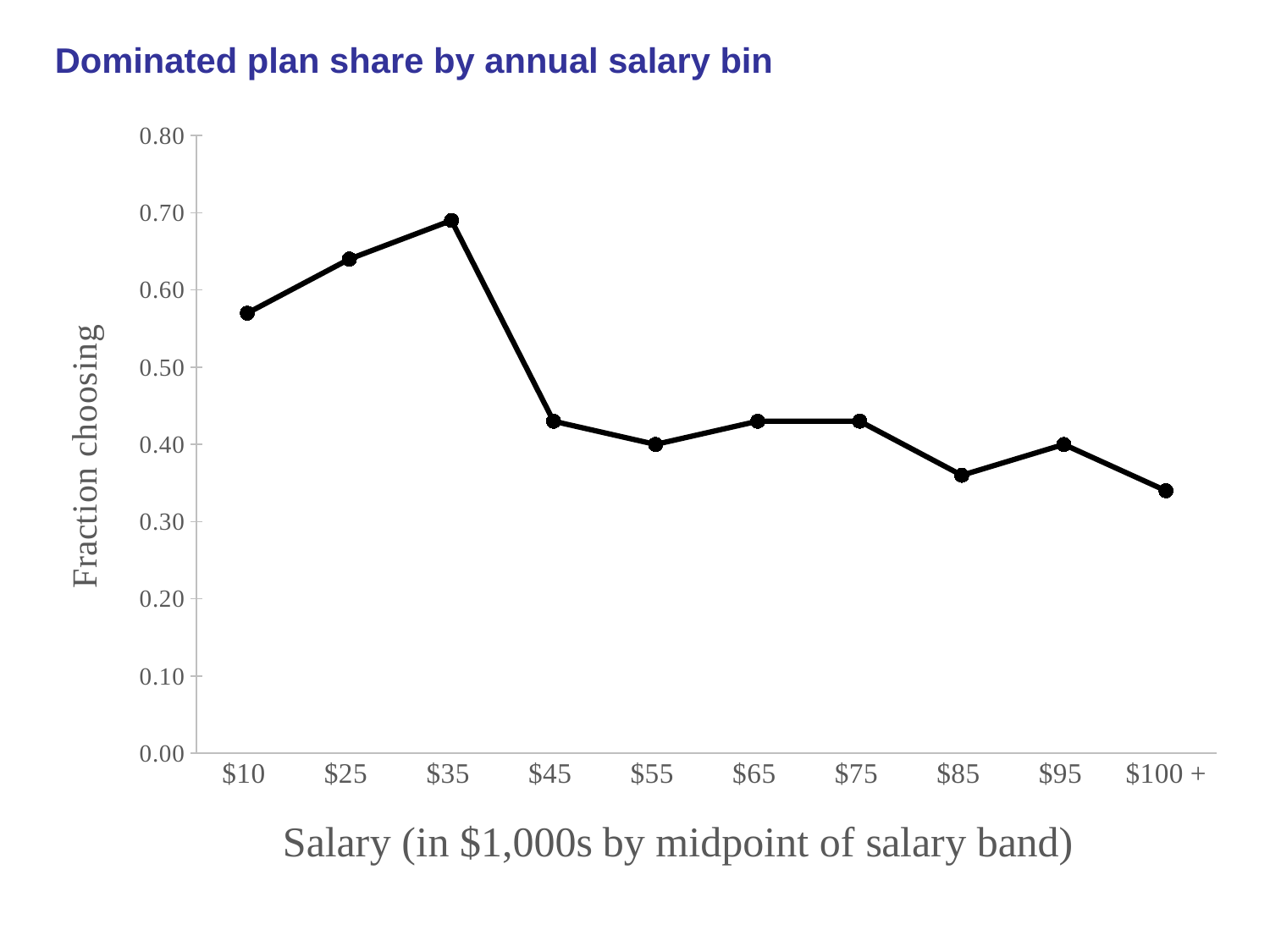
Is the fraction choosing for the $100 + salary bin greater or less than 0.40? less Overall, does the fraction choosing rise or fall as salary increases from $10 to $100 +? fall Is the fraction choosing for the $25 salary bin greater or less than 0.60? greater Which has a larger fraction choosing, the $35 bin or the $45 bin? $35 What kind of chart is shown on the slide? line chart Is the fraction choosing for the $10 salary bin greater or less than 0.50? greater What is the label on the y axis of the chart? Fraction choosing Which salary bin has the highest fraction choosing the dominated plan? $35 What is the title of the chart? Dominated plan share by annual salary bin How many salary bins are plotted on the x axis? 10